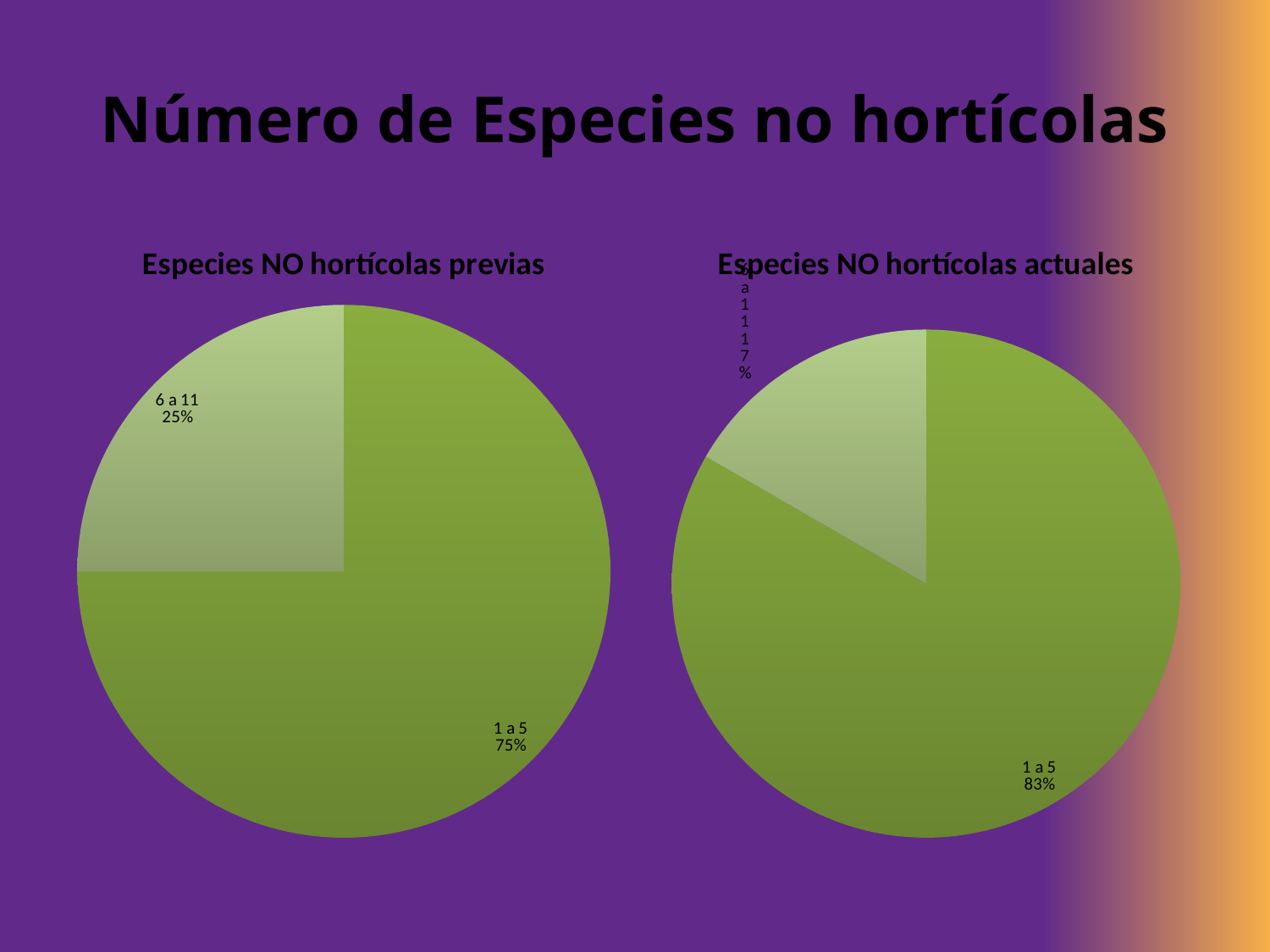
In the "Especies NO hortícolas previas" chart, what share does the "6 a 11" slice have? 25% In the "Especies NO hortícolas previas" chart, which slice is the largest? 1 a 5 In the "Especies NO hortícolas previas" chart, what is the difference between the "1 a 5" share and the "6 a 11" share? 50% In the "Especies NO hortícolas actuales" chart, what share does the "1 a 5" slice have? 83% Which chart has the larger share for "1 a 5": "Especies NO hortícolas previas" or "Especies NO hortícolas actuales"? Especies NO hortícolas actuales What kind of chart is "Especies NO hortícolas previas"? pie chart In the "Especies NO hortícolas previas" chart, what share does the "1 a 5" slice have? 75% What is the title of the pie chart on the right of the slide? Especies NO hortícolas actuales In the "Especies NO hortícolas previas" chart, which slice is the smallest? 6 a 11 In the "Especies NO hortícolas actuales" chart, how many slices are there? 2 What is the title of the slide? Número de Especies no hortícolas In the "Especies NO hortícolas previas" chart, how many slices are there? 2